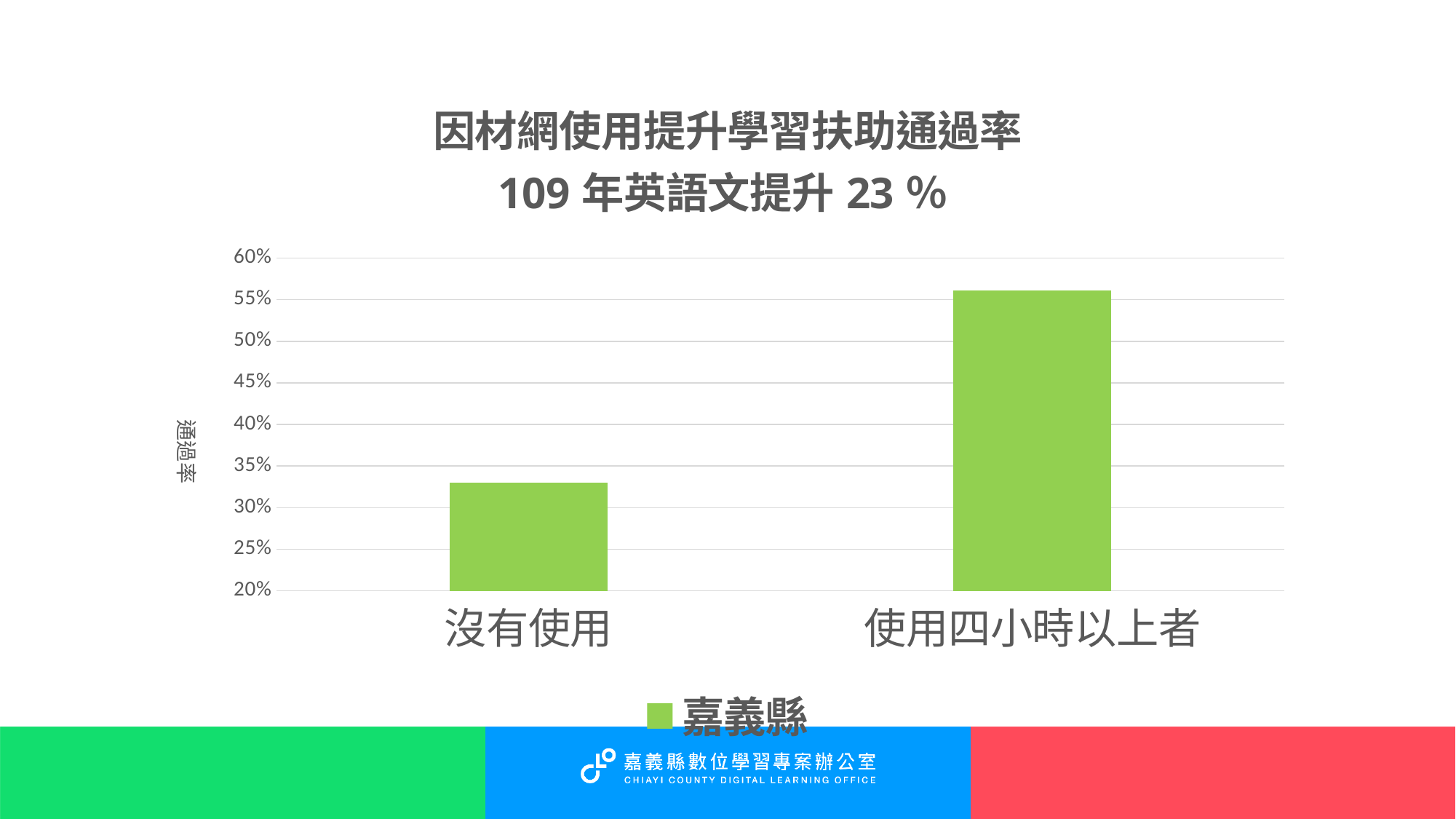
How many categories are shown on the x axis of the chart? 2 Which is larger, the value for 沒有使用 or the value for 使用四小時以上者? 使用四小時以上者 Is the value for 沒有使用 greater or less than 30%? greater Is the value for 使用四小時以上者 greater or less than 50%? greater What is the label on the vertical axis of the chart? 通過率 How many series does the chart legend list? 1 Which category has the lowest pass rate in the chart? 沒有使用 Which category has the highest pass rate in the chart? 使用四小時以上者 What is the name of the series shown in the chart legend? 嘉義縣 What kind of chart is shown on the slide? bar chart Is the value for 使用四小時以上者 greater or less than 60%? less